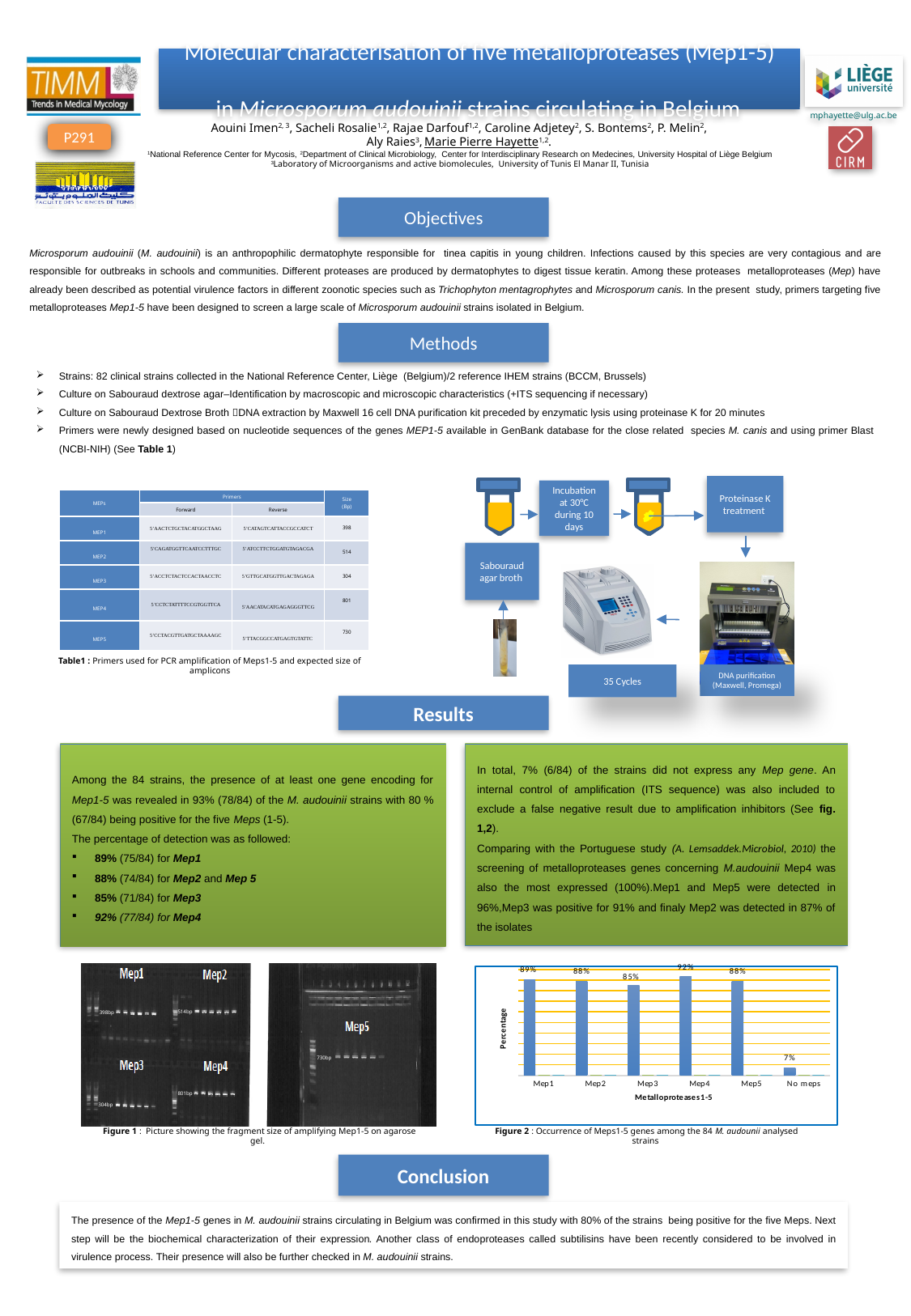
What type of chart is shown in Figure 2? bar chart In Figure 2, which is larger, the value for Mep4 or the value for Mep3? Mep4 In Figure 2, what is the value shown for Mep3? 85% In Figure 2, what is the value shown for Mep4? 92% In Figure 2, which category has the highest value? Mep4 How many categories are plotted on the x axis of the chart in Figure 2? 6 In Figure 2, what is the difference between the values for Mep4 and Mep3? 7% In Figure 2, which category has the lowest value? No meps In Figure 2, what is the value shown for Mep1? 89% In Figure 2, what is the difference between the values for Mep1 and No meps? 82% In Figure 2, what is the value shown for No meps? 7% What is the label of the vertical axis of the chart in Figure 2? Percentage